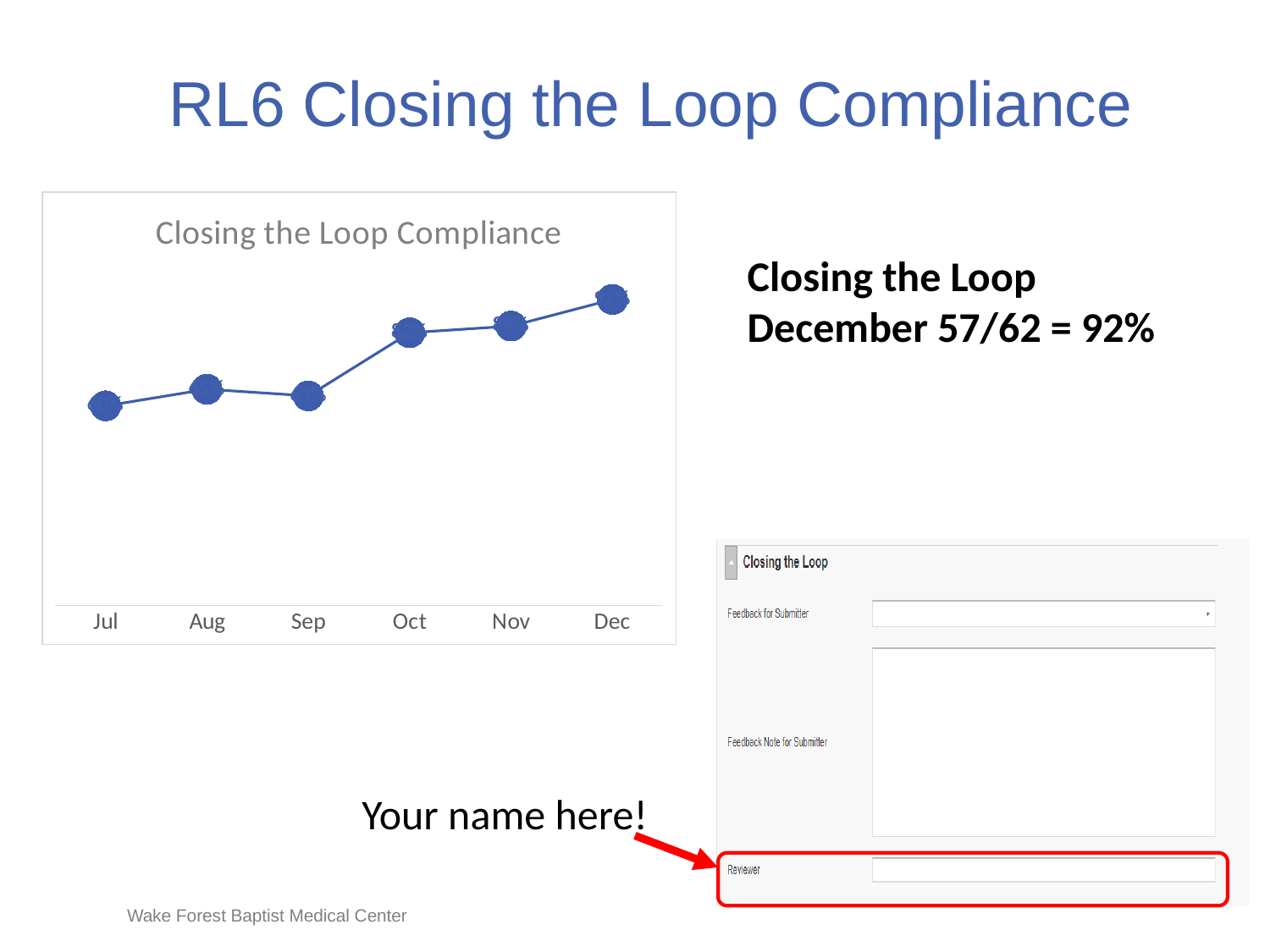
Is the value for Nov larger or smaller than the value for Aug? larger Is the value for Oct larger or smaller than the value for Sep? larger Which month is the first category on the x axis? Jul What is the title of the chart? Closing the Loop Compliance Is the value for Jul larger or smaller than the value for Dec? smaller Do the values generally rise or fall from Jul to Dec? rise What colour is the line in the chart? blue Which month has the highest value in the Closing the Loop Compliance chart? Dec What kind of chart is shown on the slide? line chart How many months are plotted on the x axis of the chart? 6